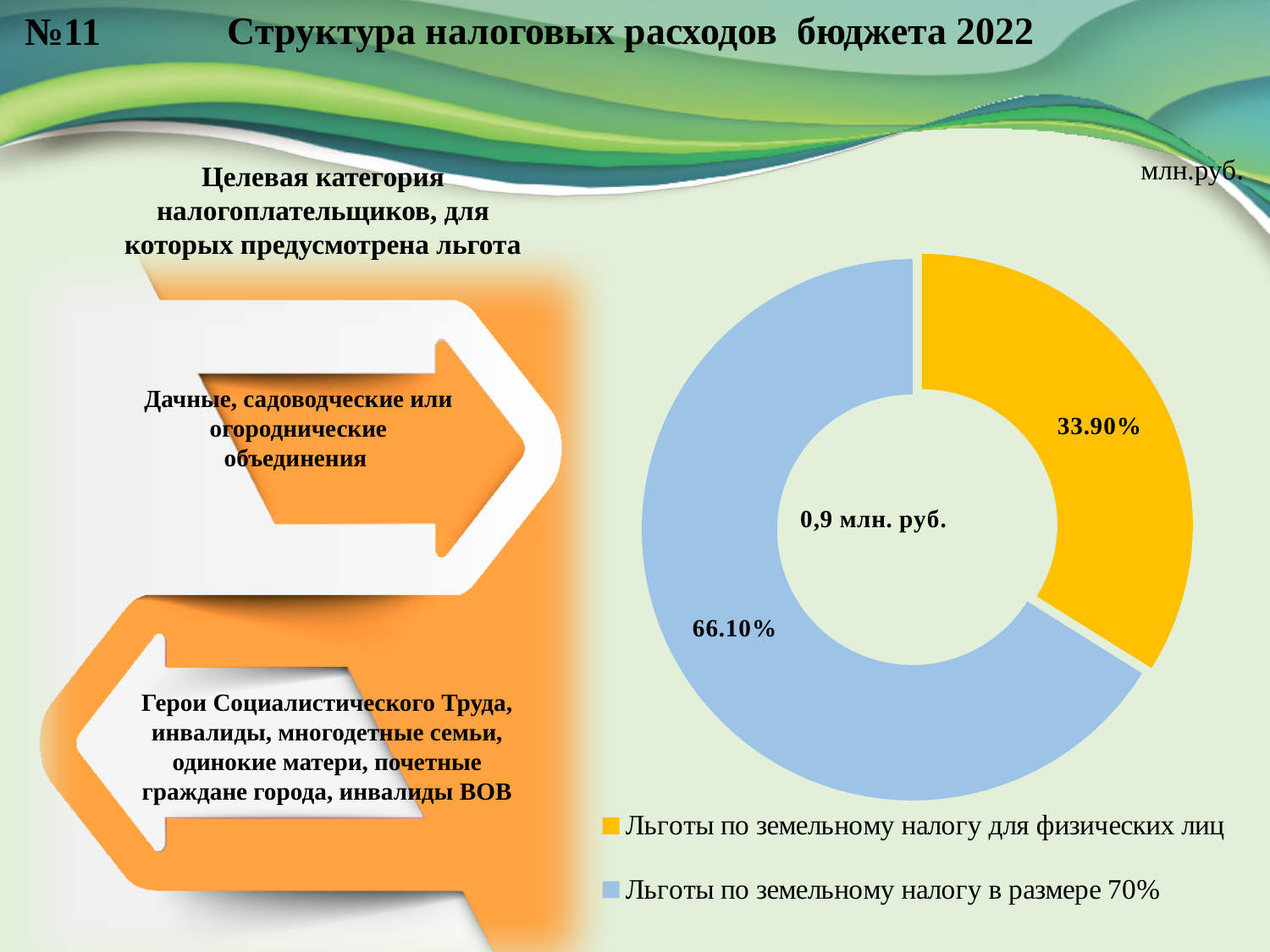
What share of the chart is labelled for "Льготы по земельному налогу в размере 70%"? 66.10% What total value is printed in the centre of the doughnut chart? 0,9 млн. руб. What share of the chart is labelled for "Льготы по земельному налогу для физических лиц"? 33.90% How many slices does the chart have? 2 What type of chart is shown on the slide? Doughnut (pie) chart What is the difference in percentage points between the two slices of the chart? 32.20% Which category has the largest share in the chart? Льготы по земельному налогу в размере 70% Which category has the smallest share in the chart? Льготы по земельному налогу для физических лиц Which is larger: the share for "Льготы по земельному налогу для физических лиц" or the share for "Льготы по земельному налогу в размере 70%"? Льготы по земельному налогу в размере 70% What colour is the slice for "Льготы по земельному налогу в размере 70%"? Light blue What is the title of the slide containing the chart? Структура налоговых расходов бюджета 2022 How many entries does the chart legend list? 2